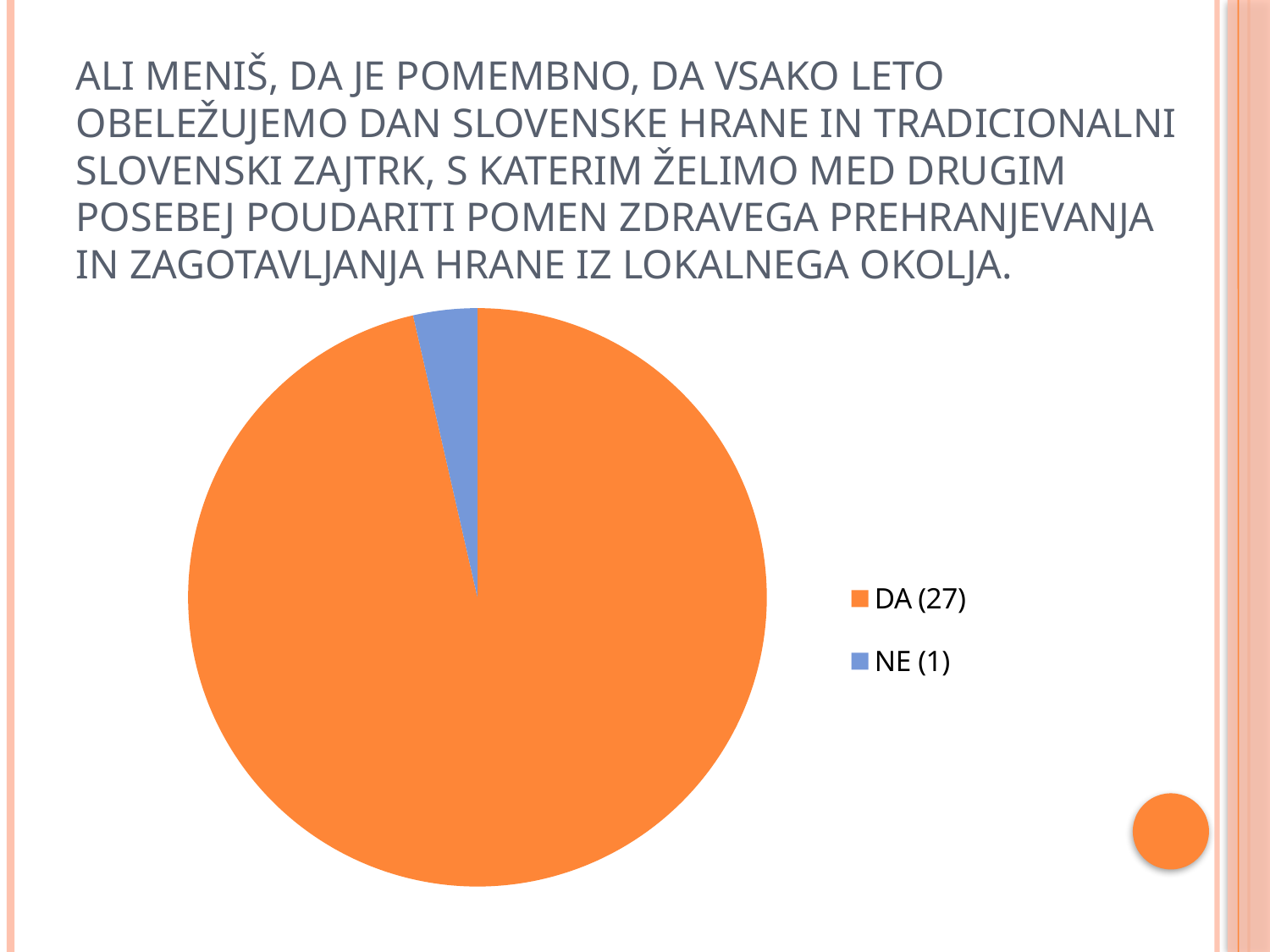
How many respondents answered NE? 1 How many slices does the pie chart have? 2 What colour is the slice for DA (27)? orange Which answer has the largest slice of the pie? DA (27) Which answer has the smallest slice of the pie? NE (1) How many respondents answered DA? 27 What is the difference between the number of DA and NE answers? 26 How many entries does the legend list? 2 What colour is the slice for NE (1)? blue What is the total number of responses shown in the pie chart? 28 Which is larger, the number of DA answers or the number of NE answers? DA What kind of chart is shown on the slide? pie chart